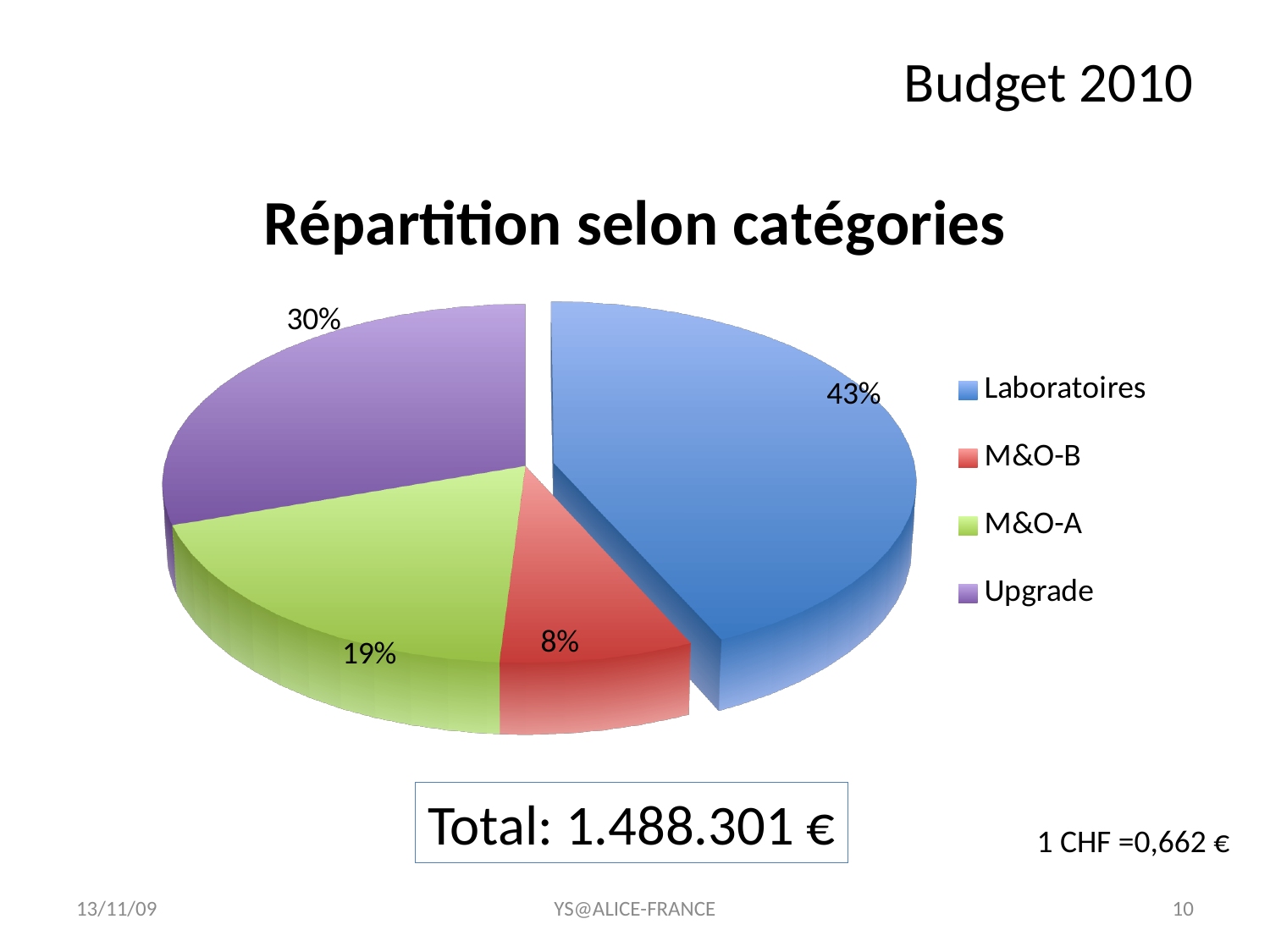
What share of the pie does M&O-A represent? 19% Which category has the largest share of the pie? Laboratoires What is the difference in percentage points between the Laboratoires share and the Upgrade share? 13 What share of the pie does Laboratoires represent? 43% What kind of chart is shown on the slide? Pie chart What share of the pie does Upgrade represent? 30% How many categories are shown in the pie chart? 4 Which category has the smallest share of the pie? M&O-B Which has a larger share, M&O-A or Upgrade? Upgrade Which colour represents M&O-A in the pie chart? Green What is the title of the chart? Répartition selon catégories